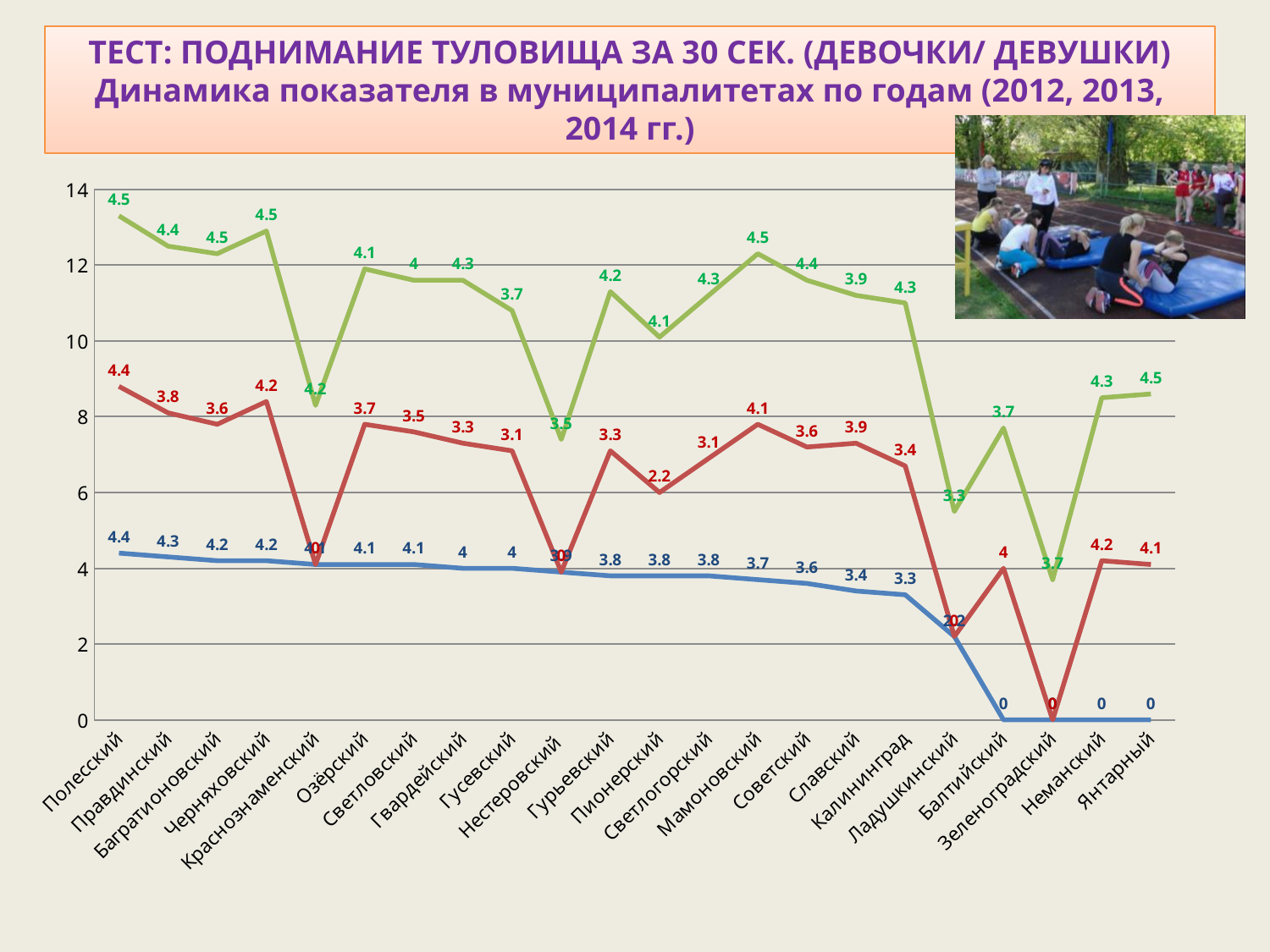
Does the blue line generally rise or fall from left to right across the municipalities? fall What is the value of the blue line for Балтийский? 0 Which municipality has the highest value on the red line? Полесский What is the value of the red line for Пионерский? 2.2 What is the value of the blue line for Калининград? 3.3 What is the difference between the red line values for Мамоновский and Пионерский? 1.9 On the red line, which is larger: the value for Гурьевский or the value for Пионерский? Гурьевский How many municipalities are shown along the x axis of the chart? 22 Which municipality has the lowest value on the green line? Ладушкинский What is the value of the green line for Ладушкинский? 3.3 What is the value of the green line for Полесский? 4.5 What type of chart is shown on the slide? line chart